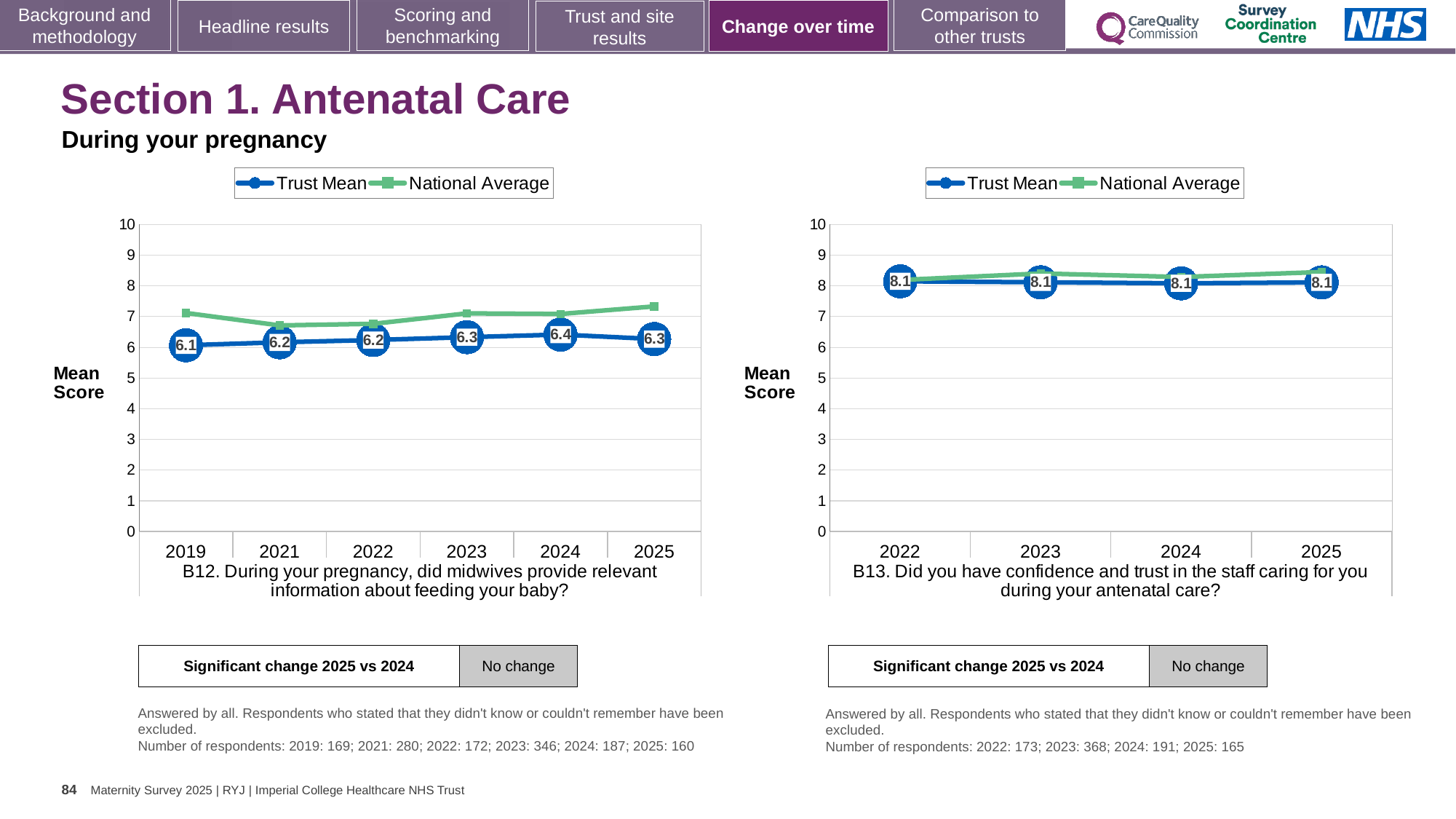
How many years are plotted on the x axis of the B13 chart on the right? 4 In the B13 chart on the right, what is the Trust Mean for 2025? 8.1 What kind of chart is the B13 chart on the right? line chart In the B12 chart on the left, is the National Average for 2025 greater or less than 7? greater In the B12 chart on the left, is the Trust Mean for 2025 larger or smaller than the Trust Mean for 2024? smaller In the B13 chart on the right, does the Trust Mean rise, fall or stay the same from 2022 to 2025? stays the same In the B12 chart on the left, what is the difference between the Trust Mean for 2024 and the Trust Mean for 2019? 0.3 In the B12 chart on the left, which year has the highest Trust Mean? 2024 How many series does the legend of the B12 chart on the left list? 2 In the B12 chart on the left, what is the Trust Mean for 2019? 6.1 In the B12 chart on the left, which year has the lowest Trust Mean? 2019 In the B12 chart on the left, what is the Trust Mean for 2024? 6.4